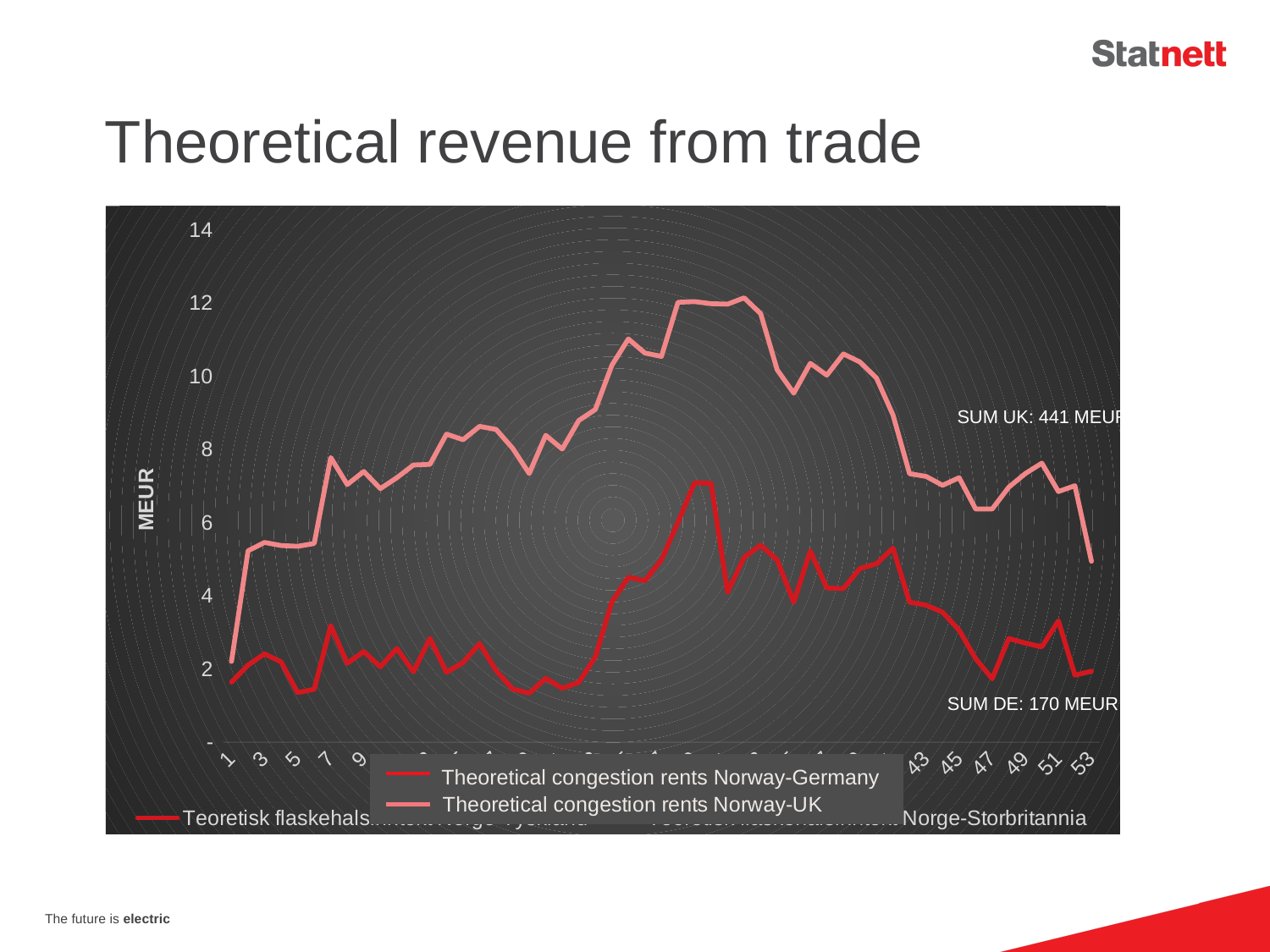
What is the title of the chart on the slide? Theoretical revenue from trade Is the value for Theoretical congestion rents Norway-Germany at week 5 greater or less than 4? less What kind of chart is shown on the slide? line chart What is the label on the vertical axis of the chart? MEUR Does the Theoretical congestion rents Norway-UK series rise or fall from week 1 to week 29? rise Which series has the larger annotated sum, Norway-UK or Norway-Germany? Norway-UK What is the difference between SUM UK and SUM DE? 271 MEUR What total is given for the Norway-UK congestion rents (SUM UK)? 441 MEUR Which series reaches the highest value on the chart? Theoretical congestion rents Norway-UK How many series does the chart legend list? 2 What total is given for the Norway-Germany congestion rents (SUM DE)? 170 MEUR Is the value for Theoretical congestion rents Norway-UK at week 29 greater or less than 10? greater